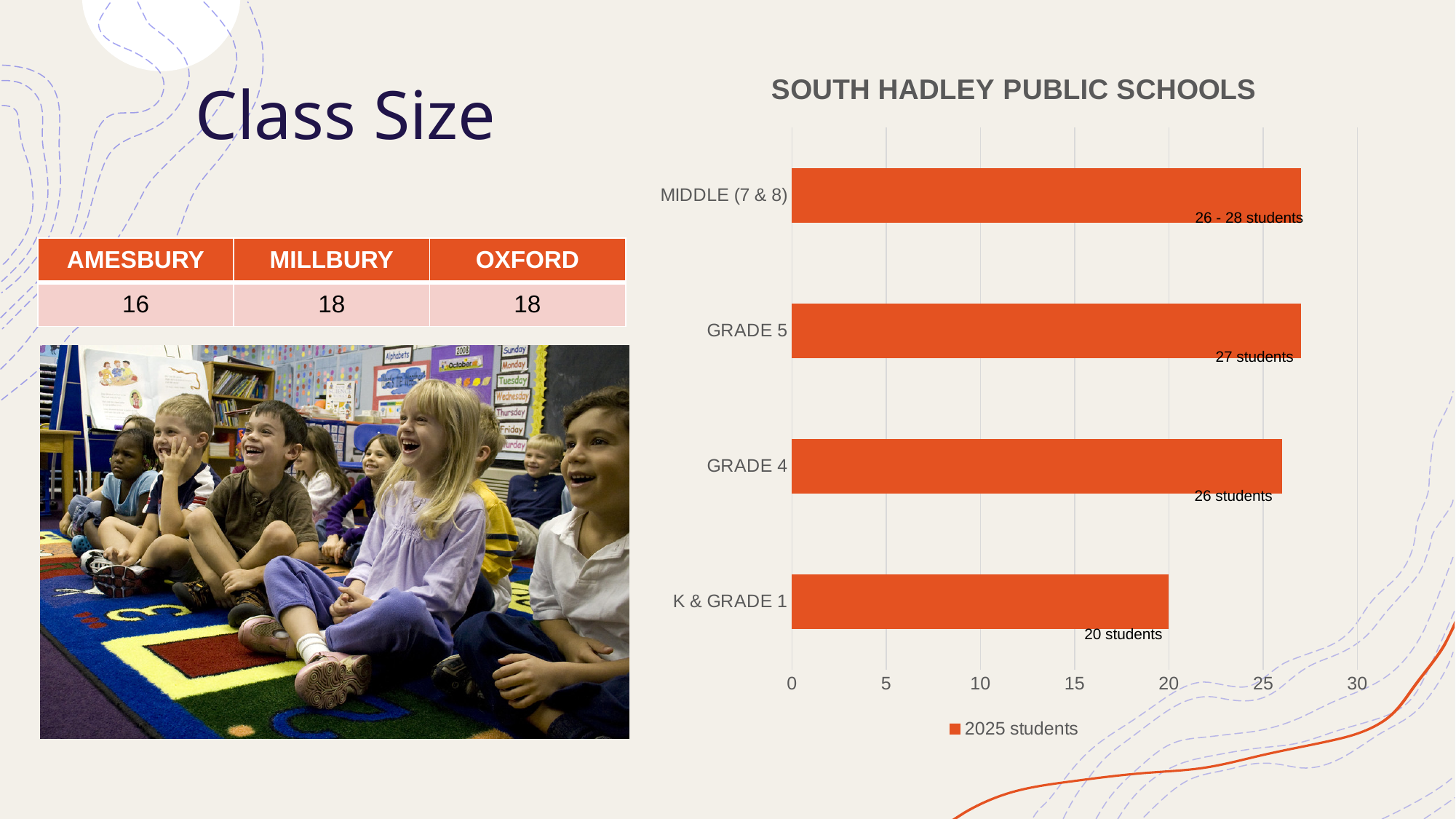
Is the value for K & GRADE 1 greater or less than 25? less What data label is shown for MIDDLE (7 & 8)? 26 - 28 students What is the class size shown for GRADE 4? 26 students What is the class size shown for K & GRADE 1? 20 students What type of chart is shown on the slide? Bar chart How many series does the chart legend list? 1 What is the difference in class size between GRADE 5 and K & GRADE 1? 7 students Which grade level has the smallest class size in the chart? K & GRADE 1 Which has a larger class size, GRADE 4 or K & GRADE 1? GRADE 4 What is the difference in class size between GRADE 4 and K & GRADE 1? 6 students How many grade-level categories are shown in the chart? 4 What is the class size shown for GRADE 5? 27 students